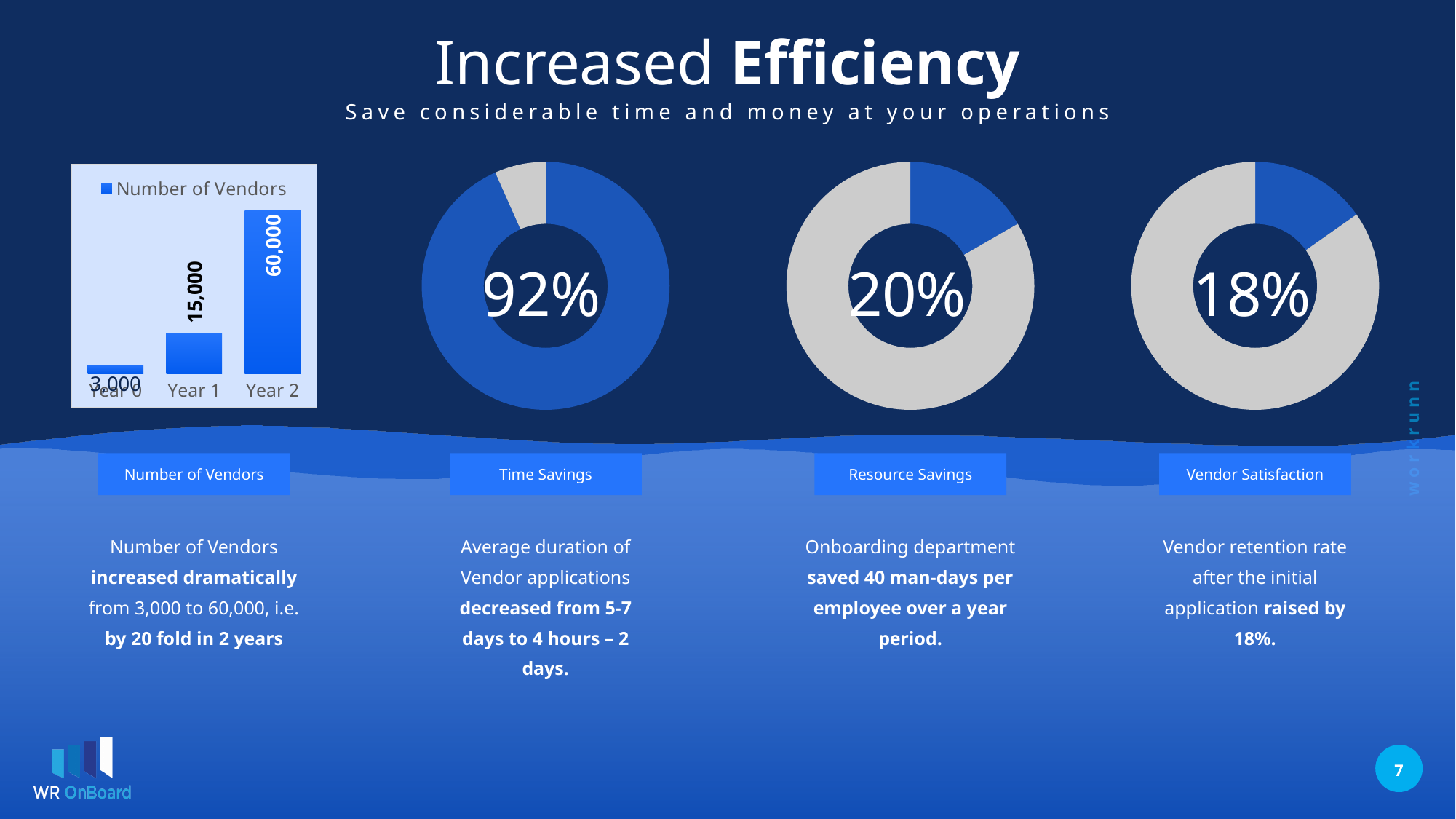
What percentage is shown in the centre of the donut chart above the Time Savings label? 92% In the Number of Vendors bar chart on the left, which year has the highest number of vendors? Year 2 In the Number of Vendors bar chart on the left, how many years (categories) are shown? 3 In the Number of Vendors bar chart on the left, do the values rise or fall from Year 0 to Year 2? Rise Which donut chart shows the larger value: the one above Resource Savings or the one above Vendor Satisfaction? Resource Savings (20%) In the Number of Vendors bar chart on the left, what is the value for Year 0? 3,000 In the Number of Vendors bar chart on the left, what is the value for Year 2? 60,000 In the Number of Vendors bar chart on the left, which year has the lowest number of vendors? Year 0 What type of chart is the Number of Vendors chart on the left? Bar chart What percentage is shown in the centre of the donut chart above the Resource Savings label? 20% In the Number of Vendors bar chart on the left, what is the value for Year 1? 15,000 In the Number of Vendors bar chart on the left, what is the difference between the Year 2 and Year 1 values? 45,000